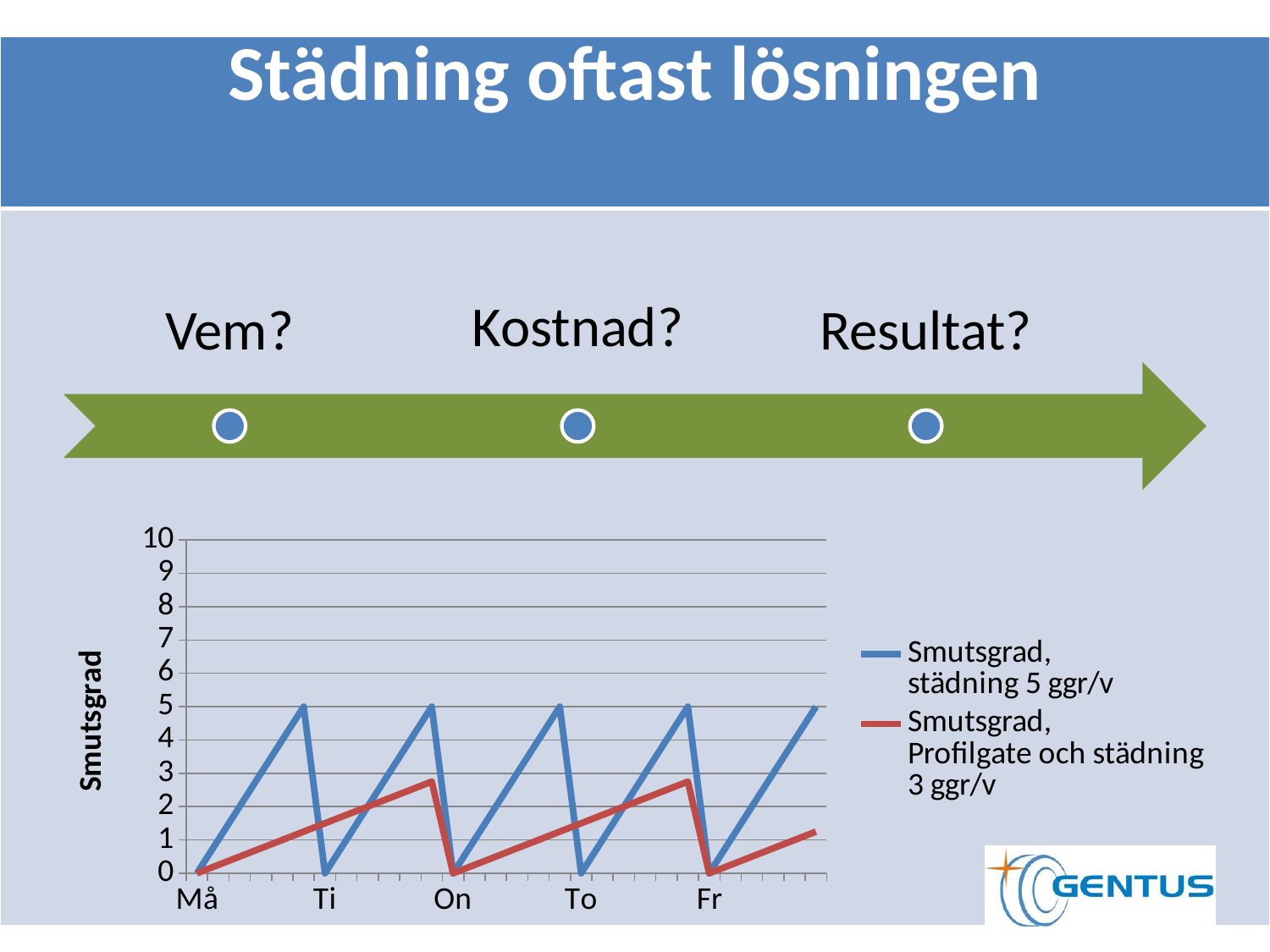
What is the highest value reached by the 'Smutsgrad, städning 5 ggr/v' series? 5 What is the legend label of the red line in the chart? Smutsgrad, Profilgate och städning 3 ggr/v Is the peak value of the 'Smutsgrad, Profilgate och städning 3 ggr/v' series greater or less than 3? less What is the value of the 'Smutsgrad, Profilgate och städning 3 ggr/v' series at On? 0 What is the value of the 'Smutsgrad, städning 5 ggr/v' series at Ti? 0 What is the title of the vertical axis of the chart? Smutsgrad Which series reaches the higher peak value, 'Smutsgrad, städning 5 ggr/v' or 'Smutsgrad, Profilgate och städning 3 ggr/v'? Smutsgrad, städning 5 ggr/v What kind of chart is shown on the slide? line chart Is the peak value of the 'Smutsgrad, Profilgate och städning 3 ggr/v' series greater or less than 2? greater How many day labels are shown on the x axis of the chart? 5 How many series does the chart legend list? 2 What is the value of the 'Smutsgrad, Profilgate och städning 3 ggr/v' series at Må? 0